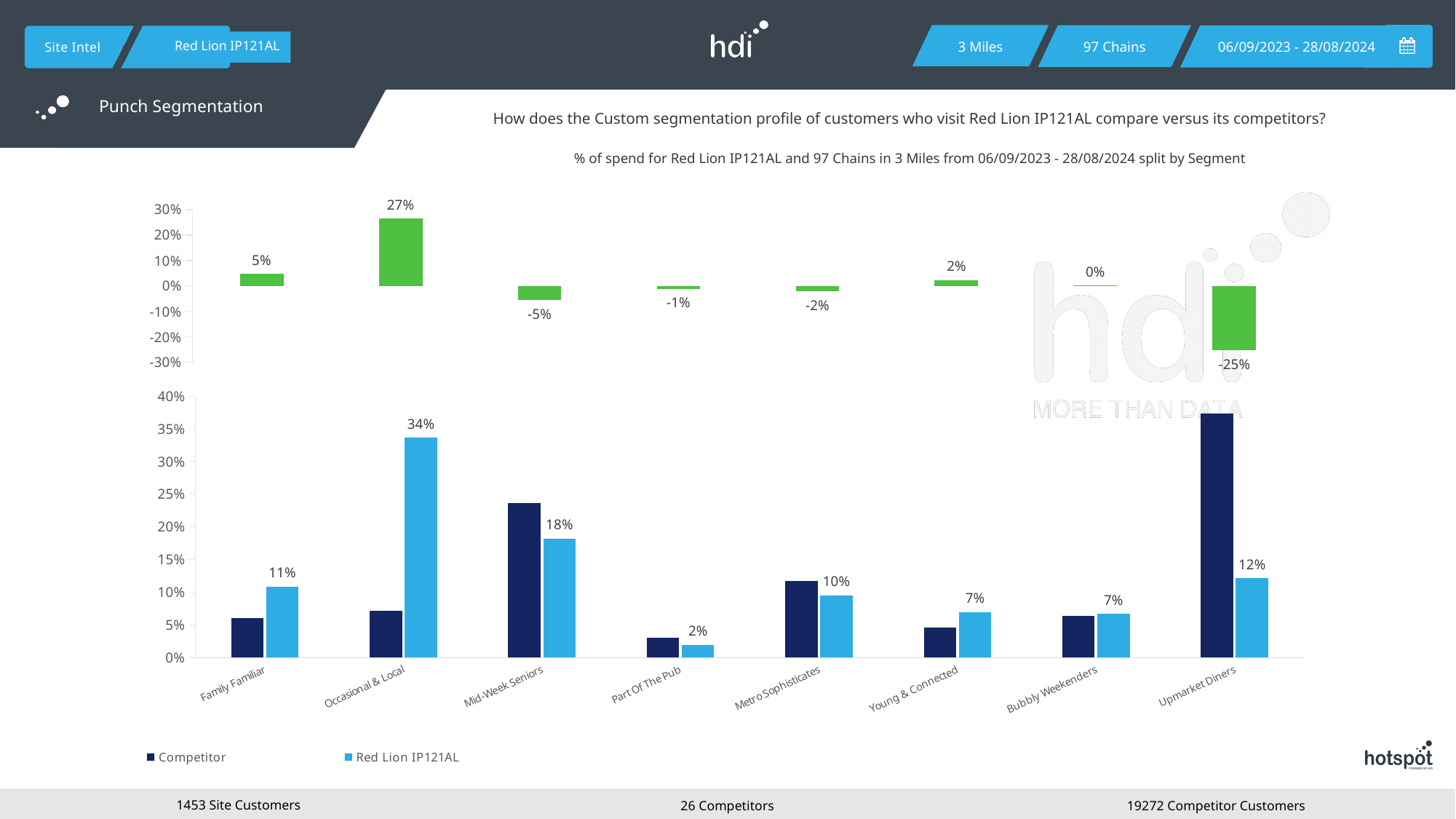
In the top chart, which segment has the lowest value? Upmarket Diners In the bottom chart, what is the difference between the Red Lion IP121AL values for Occasional & Local and Mid-Week Seniors? 16% In the bottom chart, which is larger for Mid-Week Seniors: the Competitor bar or the Red Lion IP121AL bar? Competitor In the top chart, which segment has the highest value? Occasional & Local In the bottom chart, what is the value for Red Lion IP121AL in the Occasional & Local segment? 34% How many segments are shown on the x axis of the bottom chart? 8 In the top chart, what is the value shown for Upmarket Diners? -25% In the bottom chart, is the Competitor value for Upmarket Diners greater or less than 35%? greater How many series does the legend of the bottom chart list? 2 In the bottom chart, what is the value for Red Lion IP121AL in the Upmarket Diners segment? 12% What type of chart is the bottom chart? Bar chart In the bottom chart, which segment has the lowest Red Lion IP121AL value? Part Of The Pub